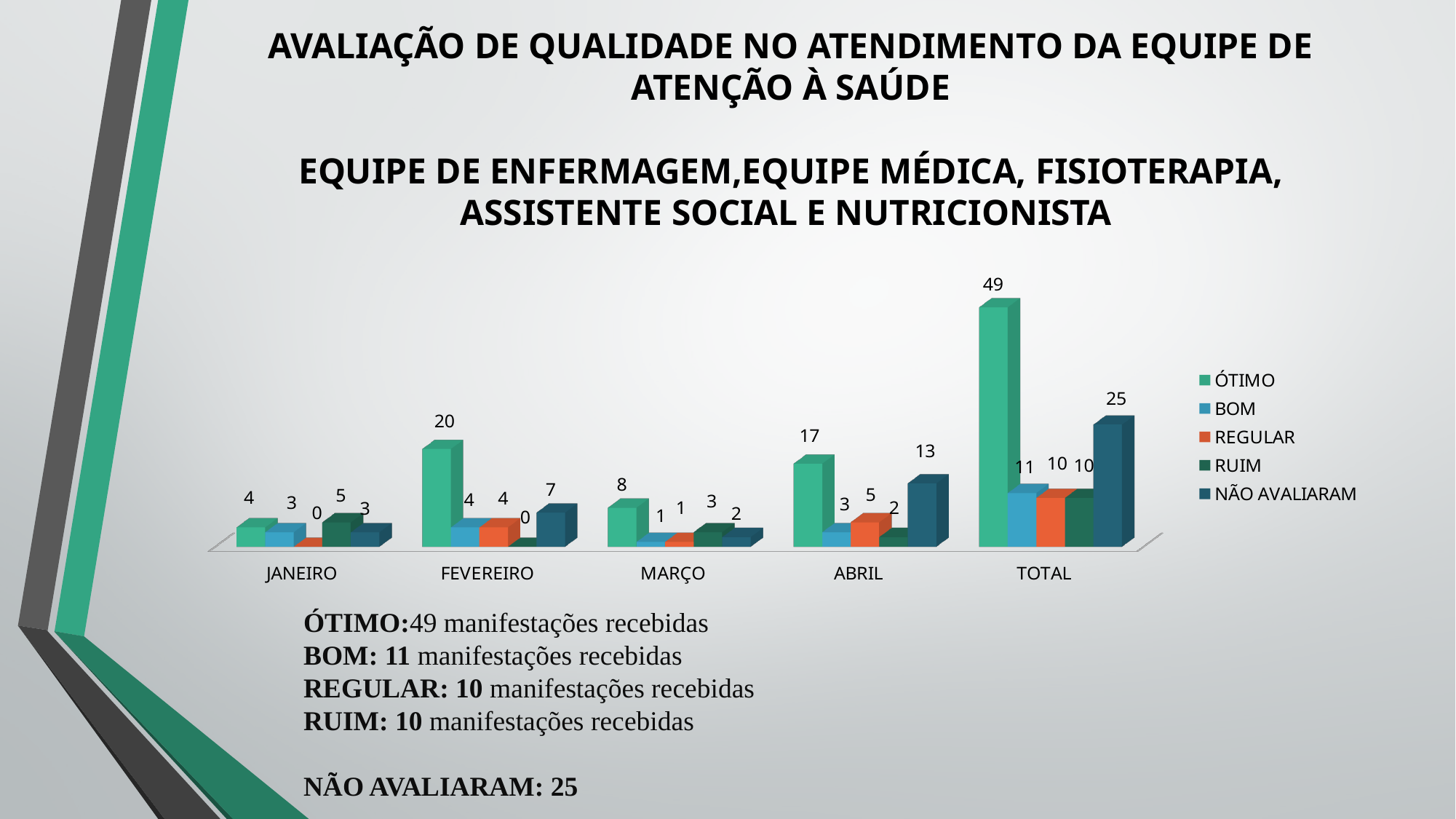
What is the value for REGULAR in MARÇO? 1 How many categories are shown on the x axis? 5 What is the value for NÃO AVALIARAM in ABRIL? 13 What is the value for ÓTIMO in FEVEREIRO? 20 What is the value for RUIM in JANEIRO? 5 What kind of chart is shown on the slide? Bar chart Which month (excluding TOTAL) has the highest value for ÓTIMO? FEVEREIRO What is the difference between the ÓTIMO value in FEVEREIRO and the ÓTIMO value in ABRIL? 3 What is the TOTAL value for BOM? 11 How many series does the legend list? 5 Which month (excluding TOTAL) has the lowest value for ÓTIMO? JANEIRO Which is larger: the NÃO AVALIARAM value in FEVEREIRO or in ABRIL? ABRIL